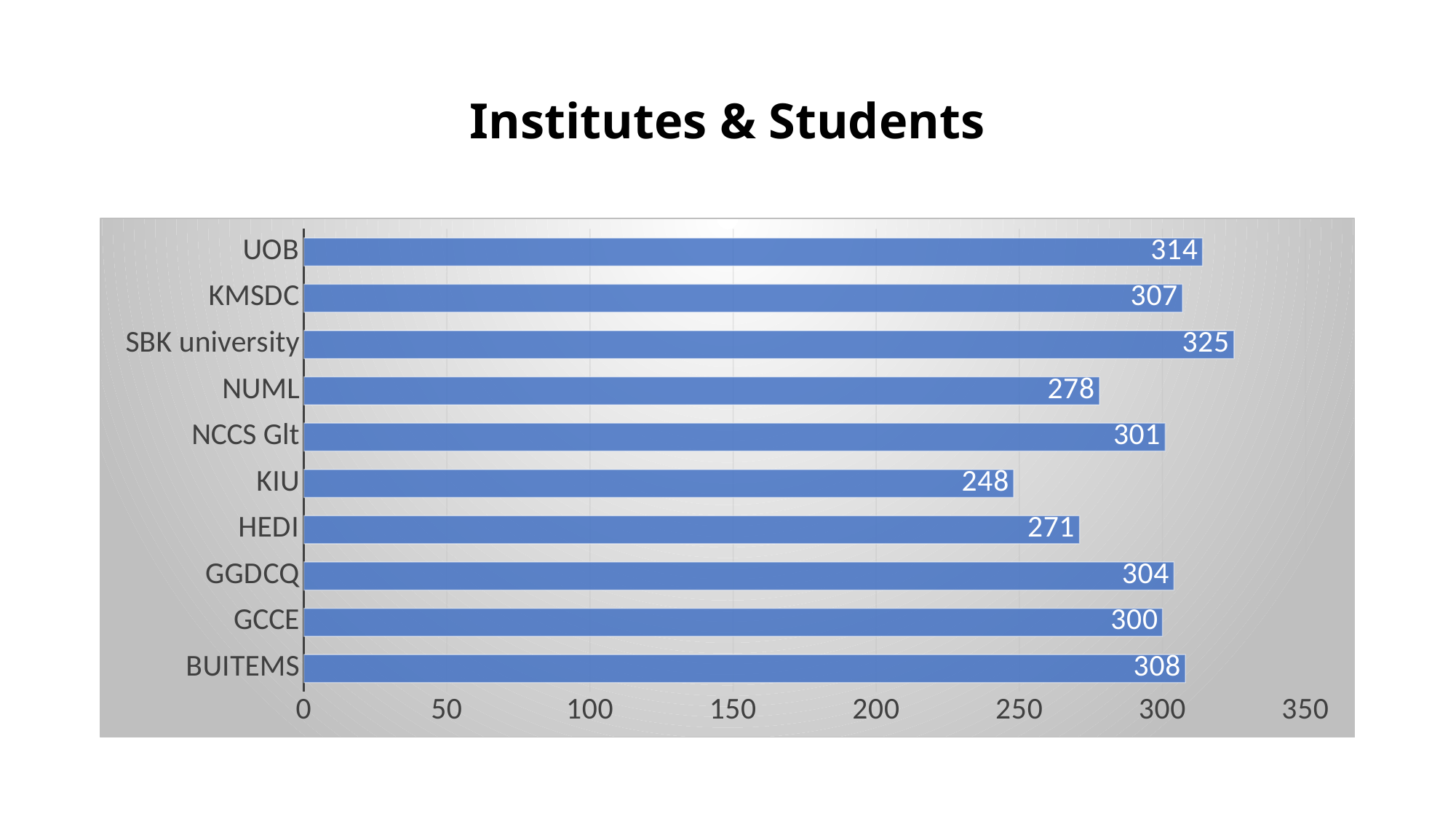
Which institute has the lowest value? KIU What is the title of the chart? Institutes & Students Is the value for GGDCQ greater or less than 300? greater What kind of chart is shown on the slide? bar chart What is the value for KIU? 248 How many institutes are shown in the chart? 10 What is the value for SBK university? 325 Which is larger, the value for NUML or the value for HEDI? NUML Which institute has the highest value? SBK university What is the difference between the values for SBK university and KIU? 77 What is the difference between the values for UOB and KMSDC? 7 What is the value for NCCS Glt? 301